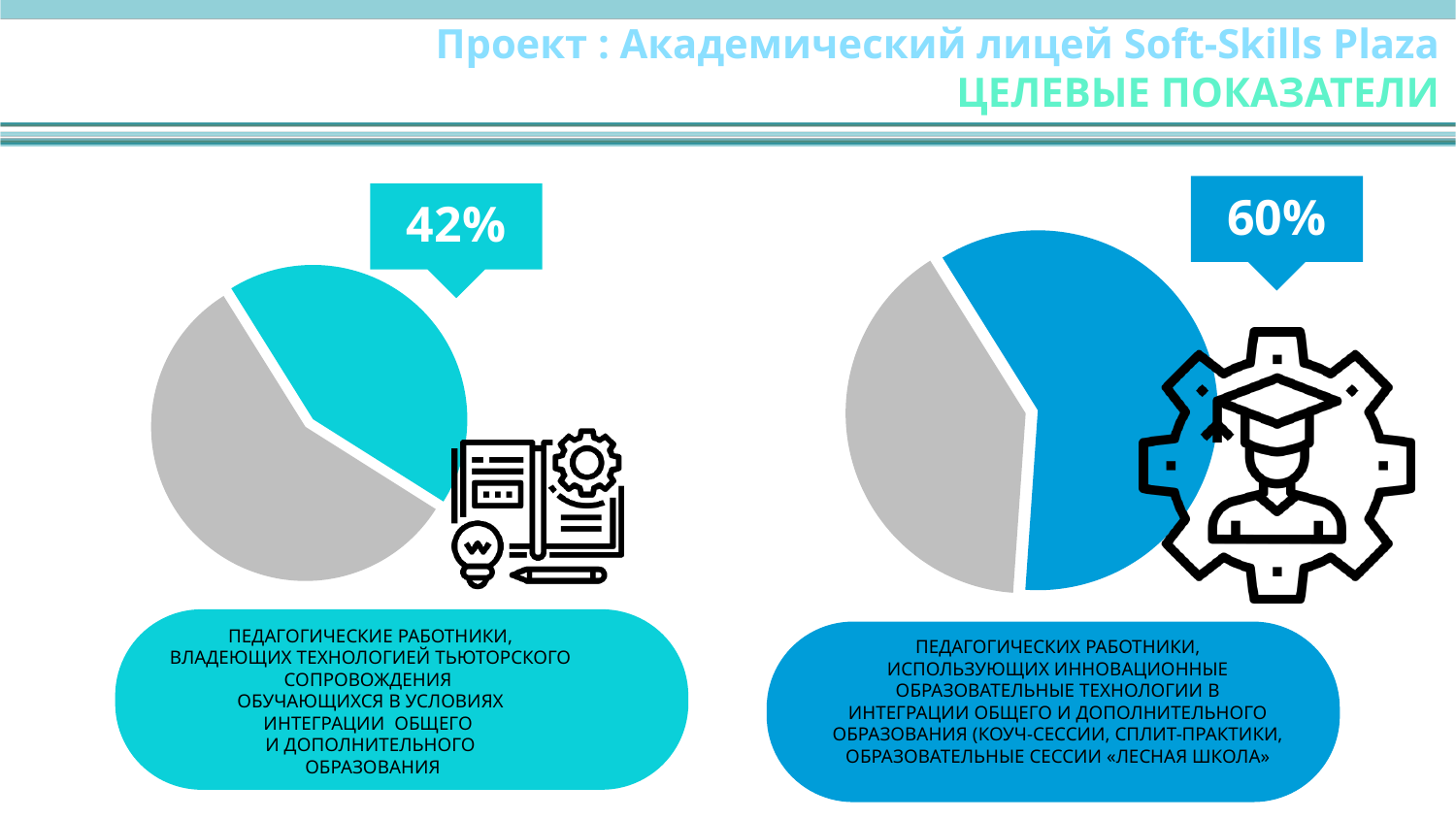
In the right pie chart, which slice is larger: the blue slice or the grey slice? The blue slice In the right pie chart, what share of the pie does the grey slice represent? 40% In the right pie chart, what percentage is shown for the highlighted (blue) slice? 60% How many slices does the right pie chart have? 2 How many slices does the left pie chart have? 2 What kind of chart is shown on the left side of the slide? Pie chart What kind of chart is shown on the right side of the slide? Pie chart What is the difference between the highlighted value in the right pie chart and the highlighted value in the left pie chart? 18 percentage points In the left pie chart, what percentage is shown for the highlighted (cyan) slice? 42% Which is larger: the highlighted value in the left pie chart (42%) or the highlighted value in the right pie chart (60%)? The right pie chart (60%) In the left pie chart, which slice is larger: the cyan slice or the grey slice? The grey slice